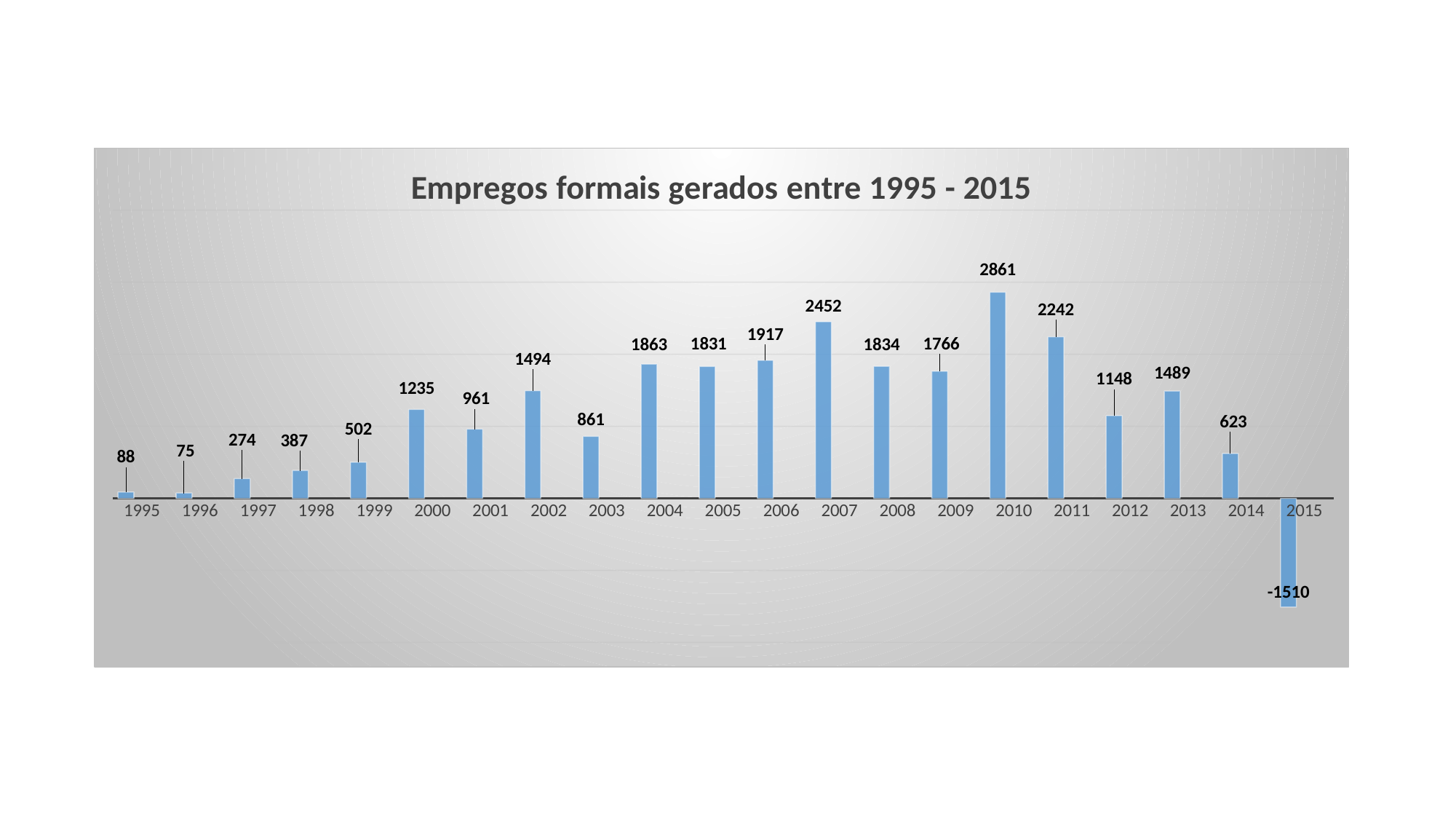
What is the value for 1999? 502 Which is larger, the value for 2004 or the value for 2005? 2004 What is the value for 2015? -1510 How many years are shown on the x axis? 21 Do the values rise or fall from 1995 to 2000? rise Which year has the highest value? 2010 What is the title of the chart? Empregos formais gerados entre 1995 - 2015 What is the difference between the values for 2010 and 2011? 619 Which year has the lowest value? 2015 What is the value for 2007? 2452 What is the difference between the values for 2013 and 2014? 866 What kind of chart is this? bar chart